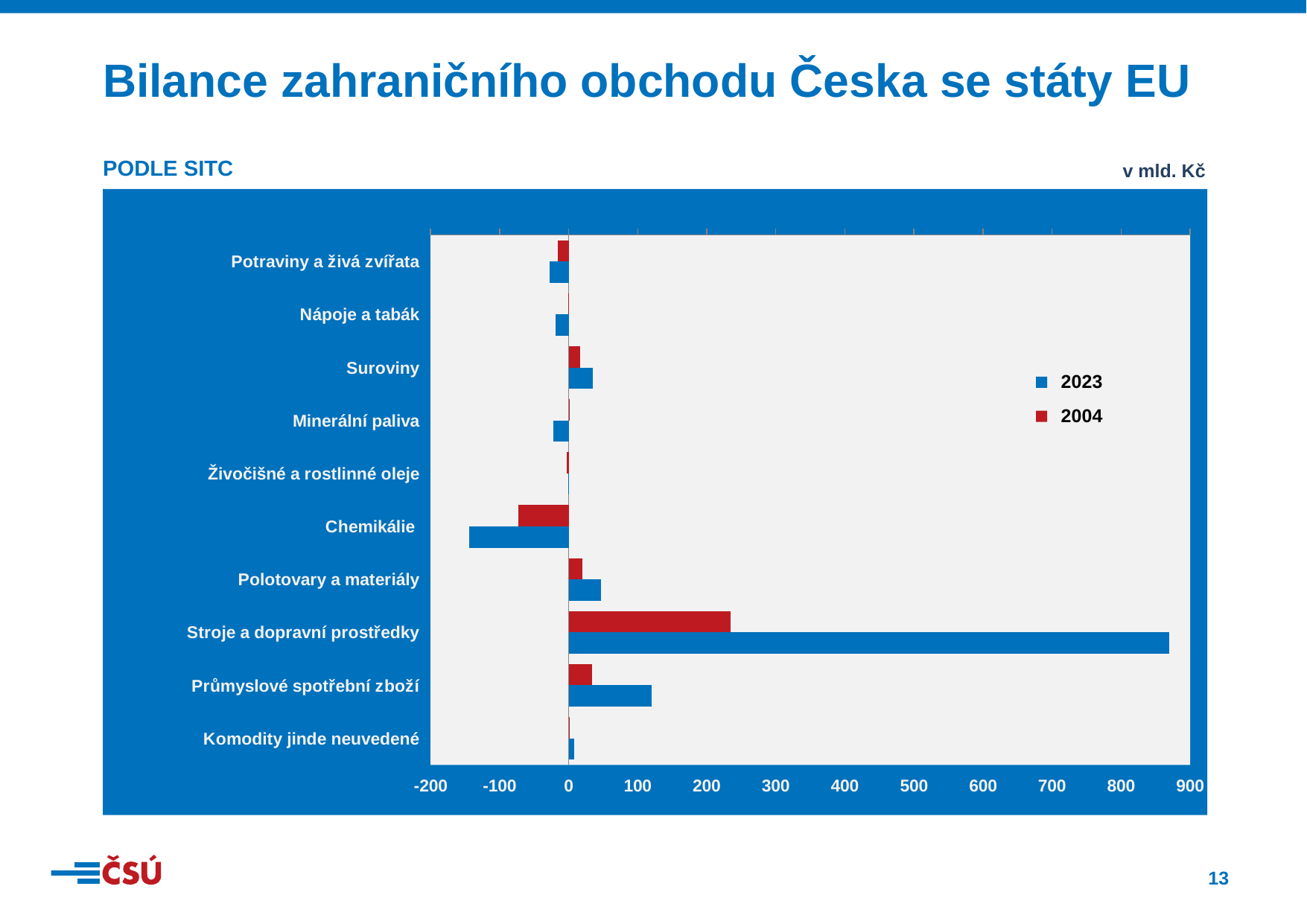
Which category has the lowest value for 2023? Chemikálie Which category has the highest value for 2004? Stroje a dopravní prostředky Is the 2023 value for Chemikálie greater or less than -100? less Which years are listed in the chart legend? 2023 and 2004 How many categories are listed on the vertical axis of the chart? 10 Which category has the lowest value for 2004? Chemikálie Is the 2023 value for Průmyslové spotřební zboží greater or less than 100? greater For Stroje a dopravní prostředky, which year has the larger value, 2023 or 2004? 2023 What kind of chart is shown on the slide? bar chart How many series does the chart legend list? 2 Is the 2023 value for Stroje a dopravní prostředky greater or less than 800? greater Which category has the highest value for 2023? Stroje a dopravní prostředky